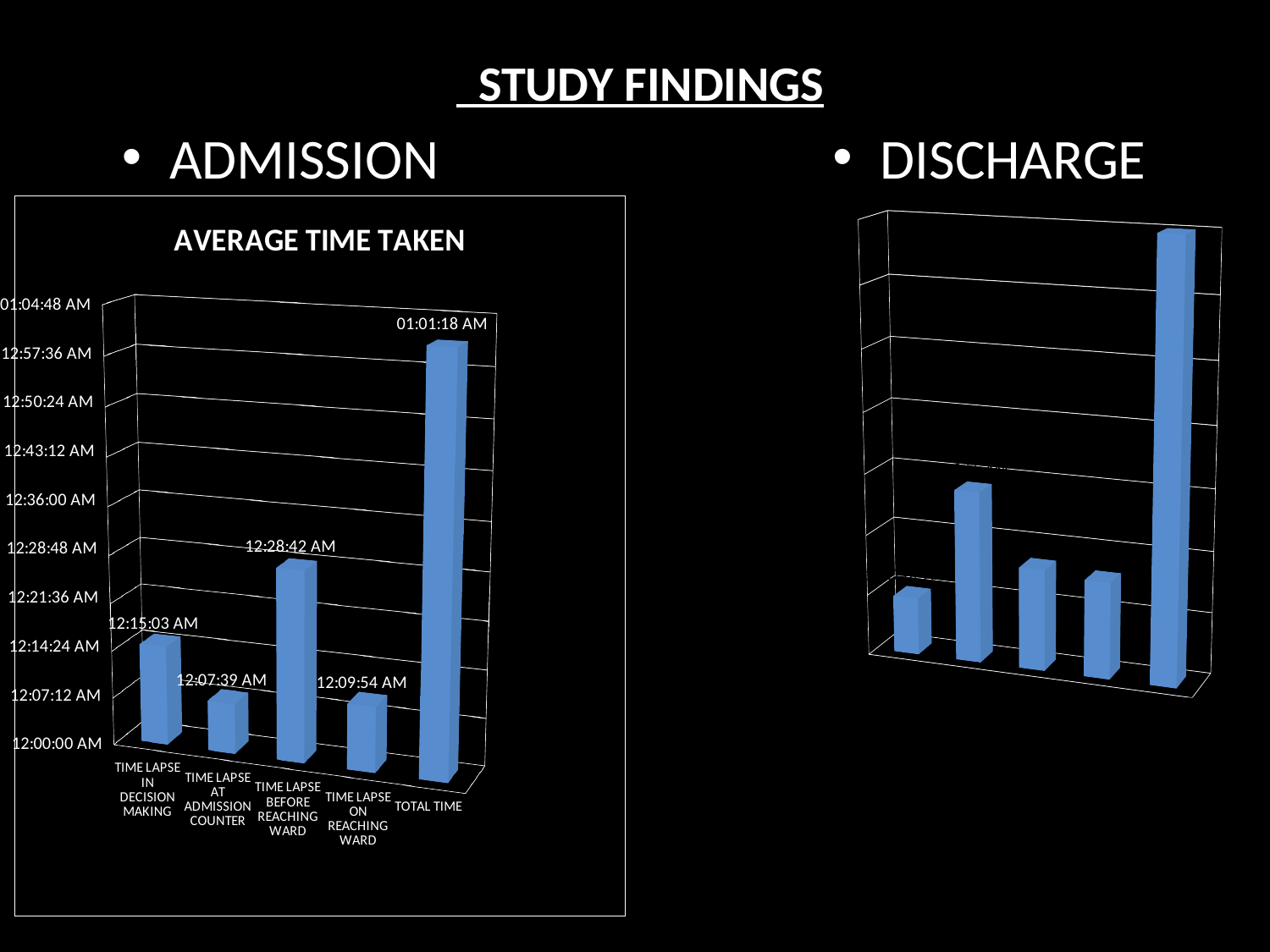
On the AVERAGE TIME TAKEN chart, which category has the highest value? TOTAL TIME On the AVERAGE TIME TAKEN chart, what is the value for TIME LAPSE AT ADMISSION COUNTER? 12:07:39 AM On the AVERAGE TIME TAKEN chart, what is the value for TOTAL TIME? 01:01:18 AM On the AVERAGE TIME TAKEN chart, which is larger: TIME LAPSE BEFORE REACHING WARD or TIME LAPSE IN DECISION MAKING? TIME LAPSE BEFORE REACHING WARD On the AVERAGE TIME TAKEN chart, is the value for TOTAL TIME greater or less than 12:57:36 AM? greater On the AVERAGE TIME TAKEN chart, what is the value for TIME LAPSE IN DECISION MAKING? 12:15:03 AM On the AVERAGE TIME TAKEN chart, what is the value for TIME LAPSE ON REACHING WARD? 12:09:54 AM What kind of chart is the AVERAGE TIME TAKEN chart under ADMISSION? bar chart On the AVERAGE TIME TAKEN chart, which category has the lowest value? TIME LAPSE AT ADMISSION COUNTER How many categories are shown on the AVERAGE TIME TAKEN chart? 5 On the AVERAGE TIME TAKEN chart, what is the value for TIME LAPSE BEFORE REACHING WARD? 12:28:42 AM How many bars are shown on the DISCHARGE chart on the right of the slide? 5